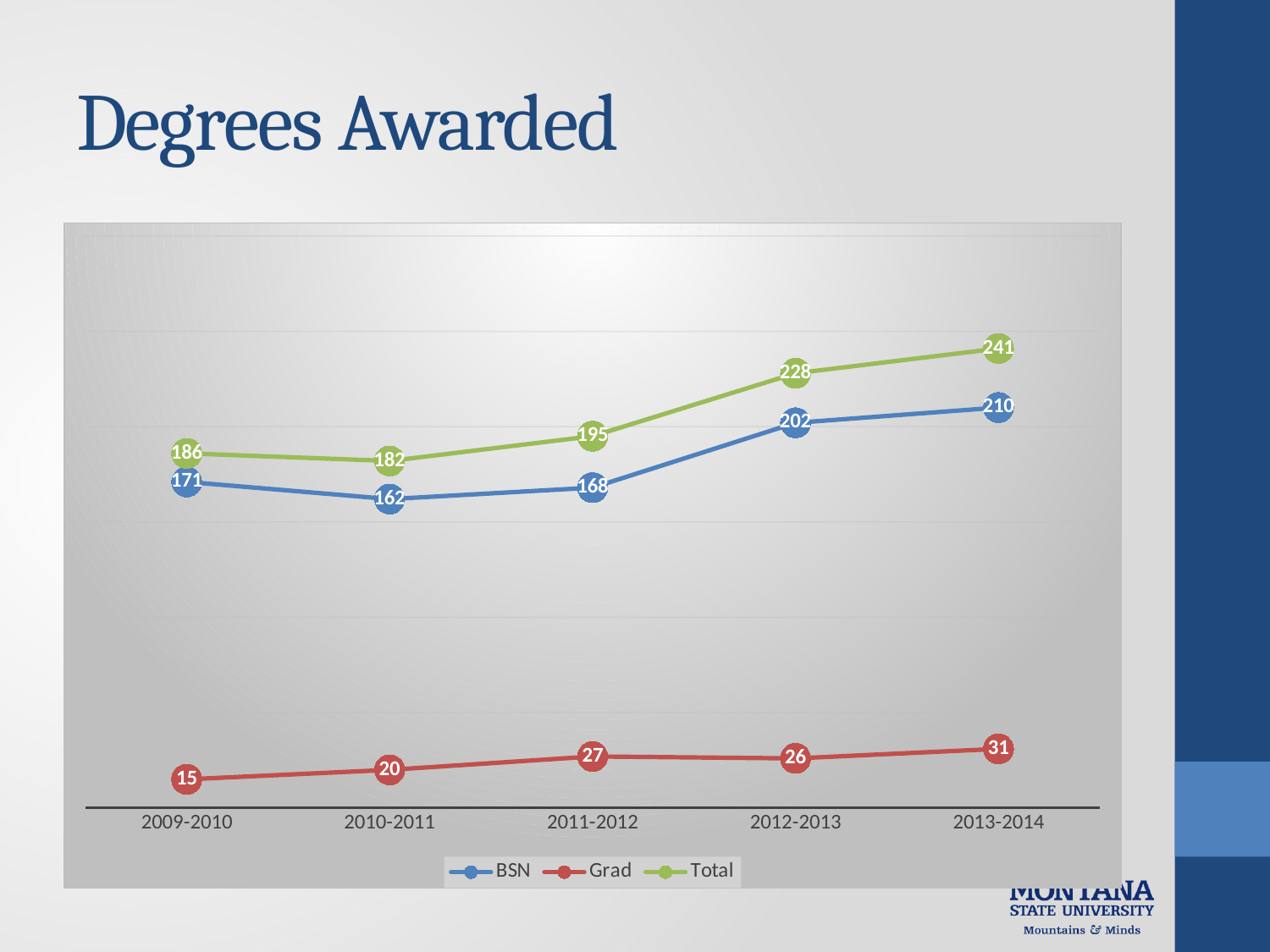
Does the Total series rise or fall from 2010-2011 to 2013-2014? Rise What is the Total value for 2012-2013? 228 In which year is the BSN value lowest? 2010-2011 How many series does the legend list? 3 How many years are shown on the x axis? 5 What is the Grad value for 2009-2010? 15 What is the BSN value for 2011-2012? 168 What is the difference between the BSN and Grad values in 2013-2014? 179 What kind of chart is shown on the slide? Line chart In which year is the Total value highest? 2013-2014 Which is larger, the Grad value for 2011-2012 or the Grad value for 2012-2013? 2011-2012 What is the difference between the Total values for 2013-2014 and 2009-2010? 55